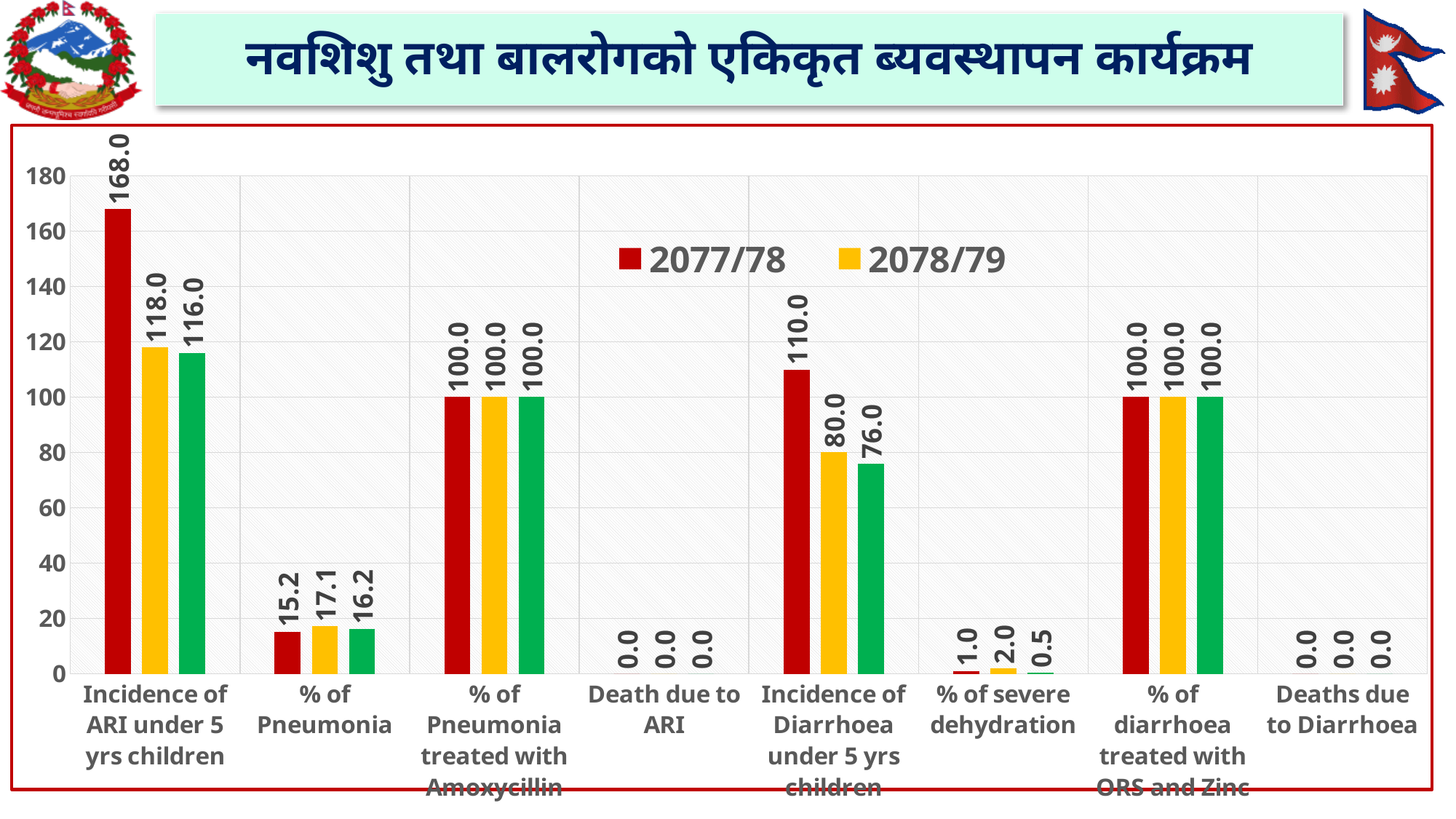
What is the difference between the 2077/78 and 2078/79 values for Incidence of ARI under 5 yrs children? 50.0 What is the value for 2078/79 for % of Pneumonia? 17.1 What is the value for 2078/79 for Incidence of Diarrhoea under 5 yrs children? 80.0 What is the value for 2077/78 for Incidence of ARI under 5 yrs children? 168.0 How many categories are shown along the x axis of the chart? 8 Which is larger for % of Pneumonia: the 2077/78 value or the 2078/79 value? 2078/79 What colour are the bars for the 2078/79 series? yellow What is the value for 2077/78 for % of severe dehydration? 1.0 What is the difference between the 2077/78 and 2078/79 values for Incidence of Diarrhoea under 5 yrs children? 30.0 How many series does the chart legend list? 2 Which category has the highest value for 2077/78? Incidence of ARI under 5 yrs children What type of chart is shown on the slide? bar chart